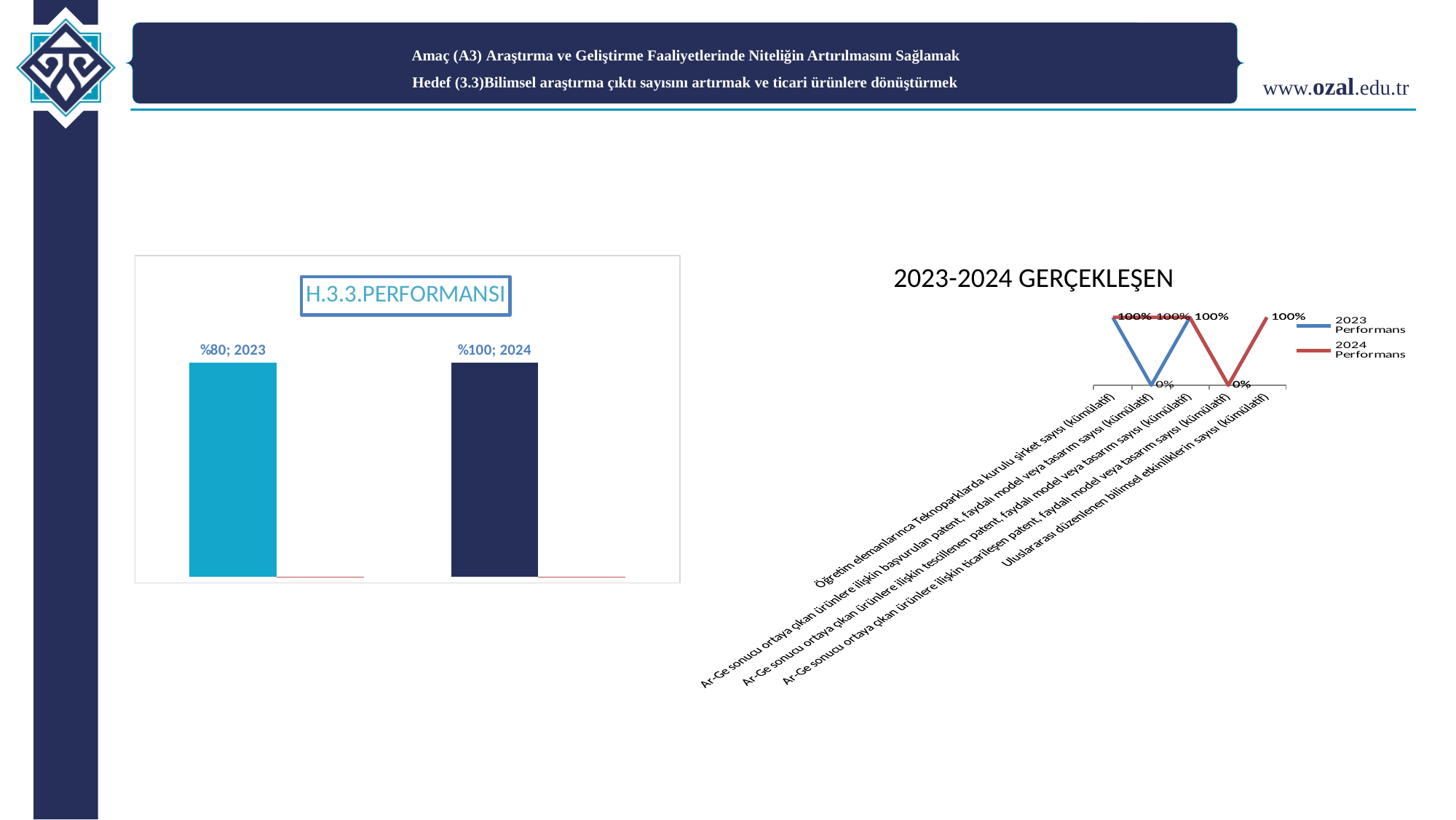
In the 2023-2024 GERÇEKLEŞEN chart, what are the two legend entries? 2023 Performans and 2024 Performans In the H.3.3.PERFORMANSI chart, what is the value for 2024? %100 What kind of chart is the H.3.3.PERFORMANSI chart? Bar chart In the 2023-2024 GERÇEKLEŞEN chart, what colour is the 2024 Performans line? Red What kind of chart is the 2023-2024 GERÇEKLEŞEN chart? Line chart In the H.3.3.PERFORMANSI chart, by how many percentage points does the 2024 value exceed the 2023 value? 20 In the H.3.3.PERFORMANSI chart, which year has the lower value? 2023 How many series does the legend of the 2023-2024 GERÇEKLEŞEN chart list? 2 In the H.3.3.PERFORMANSI chart, do the values rise or fall from 2023 to 2024? Rise In the H.3.3.PERFORMANSI chart, which year has the higher value? 2024 In the H.3.3.PERFORMANSI chart, how many bars are plotted? 2 In the H.3.3.PERFORMANSI chart, what is the value for 2023? %80